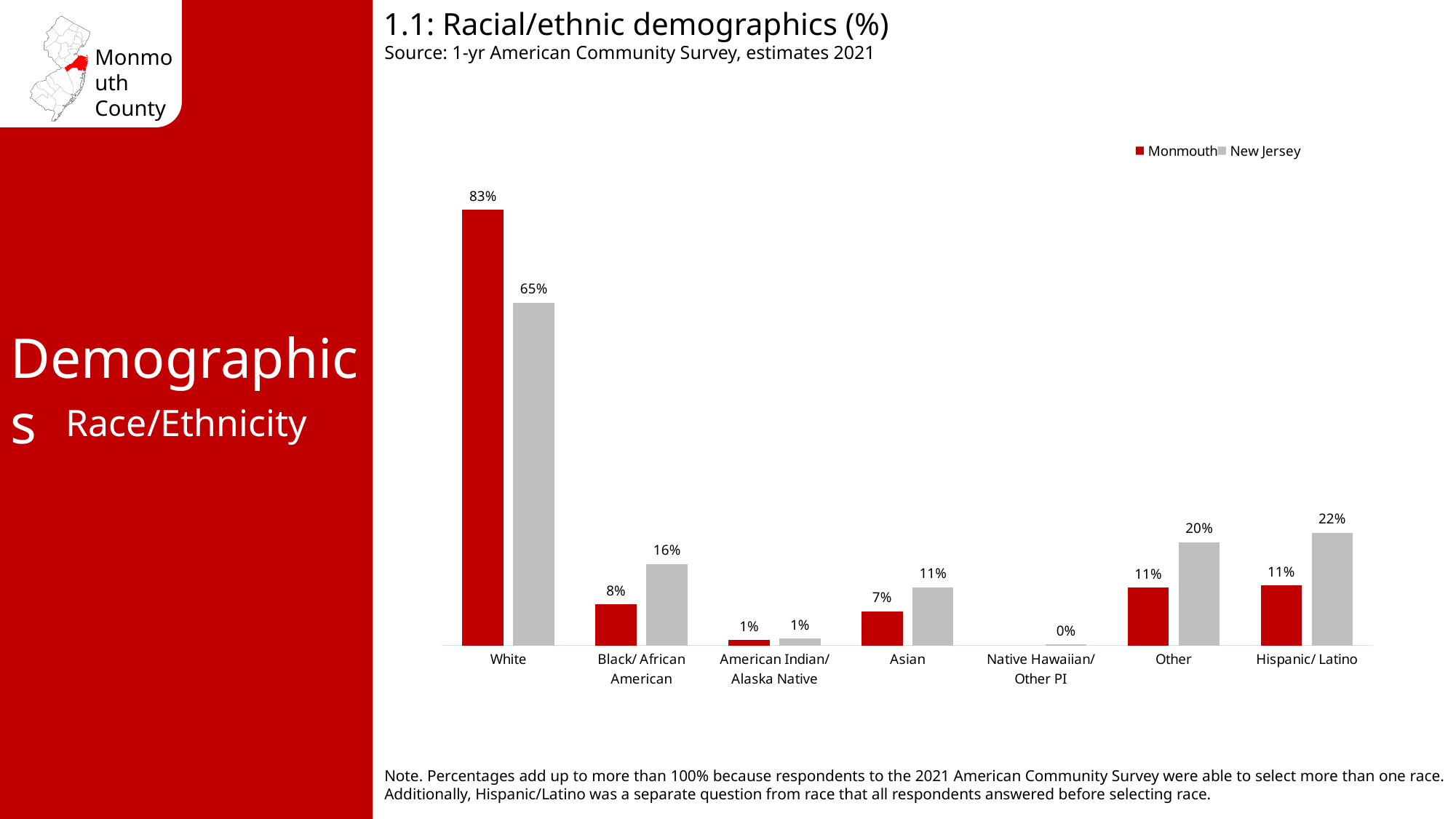
Which is larger for Black/ African American, the Monmouth value or the New Jersey value? New Jersey How many series does the legend list? 2 What is the difference between the Monmouth and New Jersey values for White? 18% Which category has the highest Monmouth value? White What is the New Jersey value for Asian? 11% Which category has the lowest New Jersey value? Native Hawaiian/ Other PI What is the New Jersey value for Hispanic/ Latino? 22% What is the Monmouth value for Black/ African American? 8% How many categories are shown on the x axis? 7 What is the Monmouth value for White? 83% What is the difference between the New Jersey and Monmouth values for Other? 9% What kind of chart is shown on the slide? Bar chart